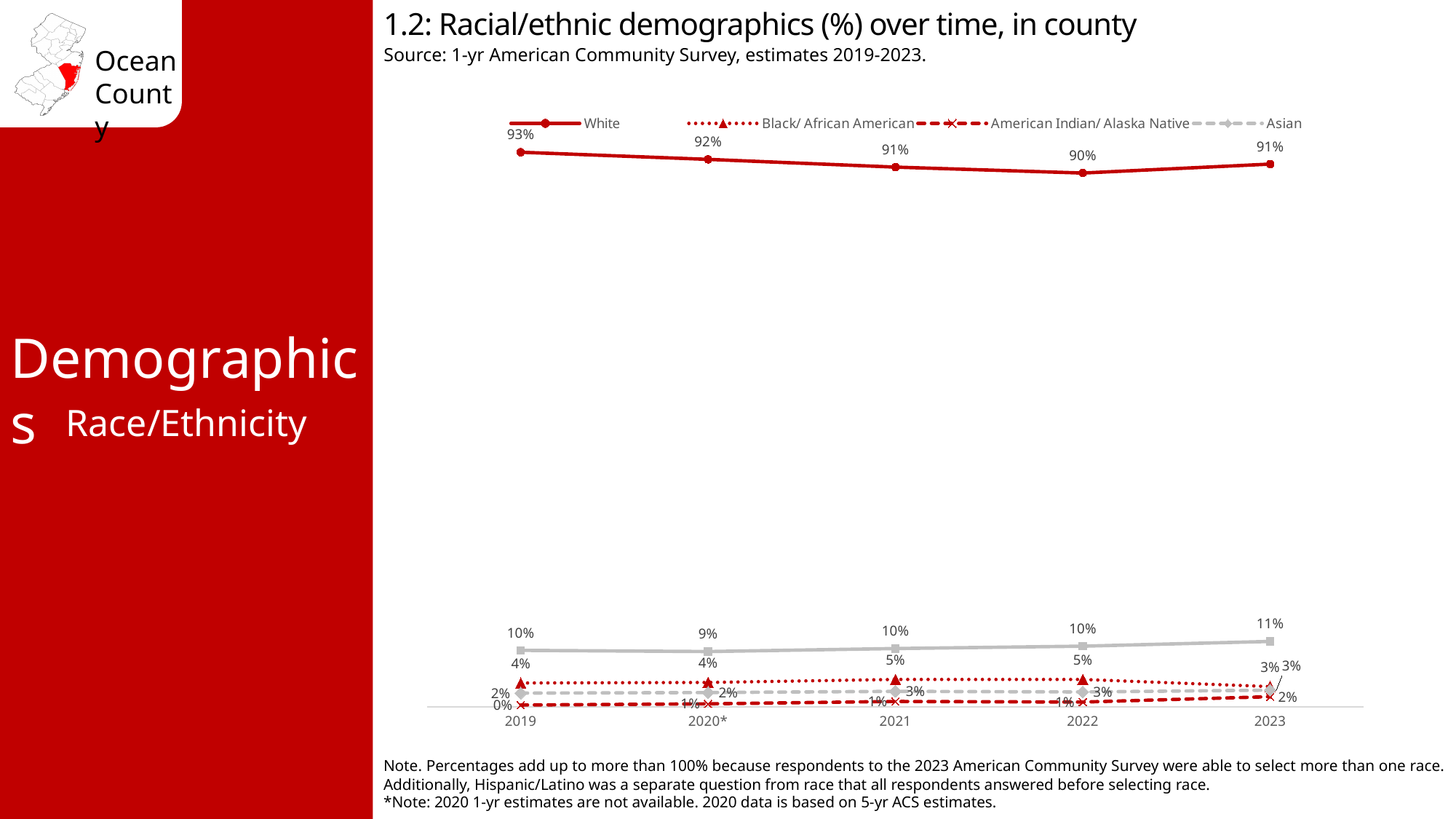
What is the value for Asian in 2019? 2% In which year is the White percentage lowest? 2022 In which year is the White percentage highest? 2019 What is the value for Black/ African American in 2021? 5% In 2022, which is larger: Black/ African American or Asian? Black/ African American Does the White percentage rise or fall from 2019 to 2022? Fall What kind of chart is shown on the slide? Line chart What is the value for American Indian/ Alaska Native in 2023? 2% What is the value for White in 2022? 90% How many years are shown on the x axis? 5 What is the value for White in 2019? 93% What is the difference between the White value in 2019 and in 2023? 2%